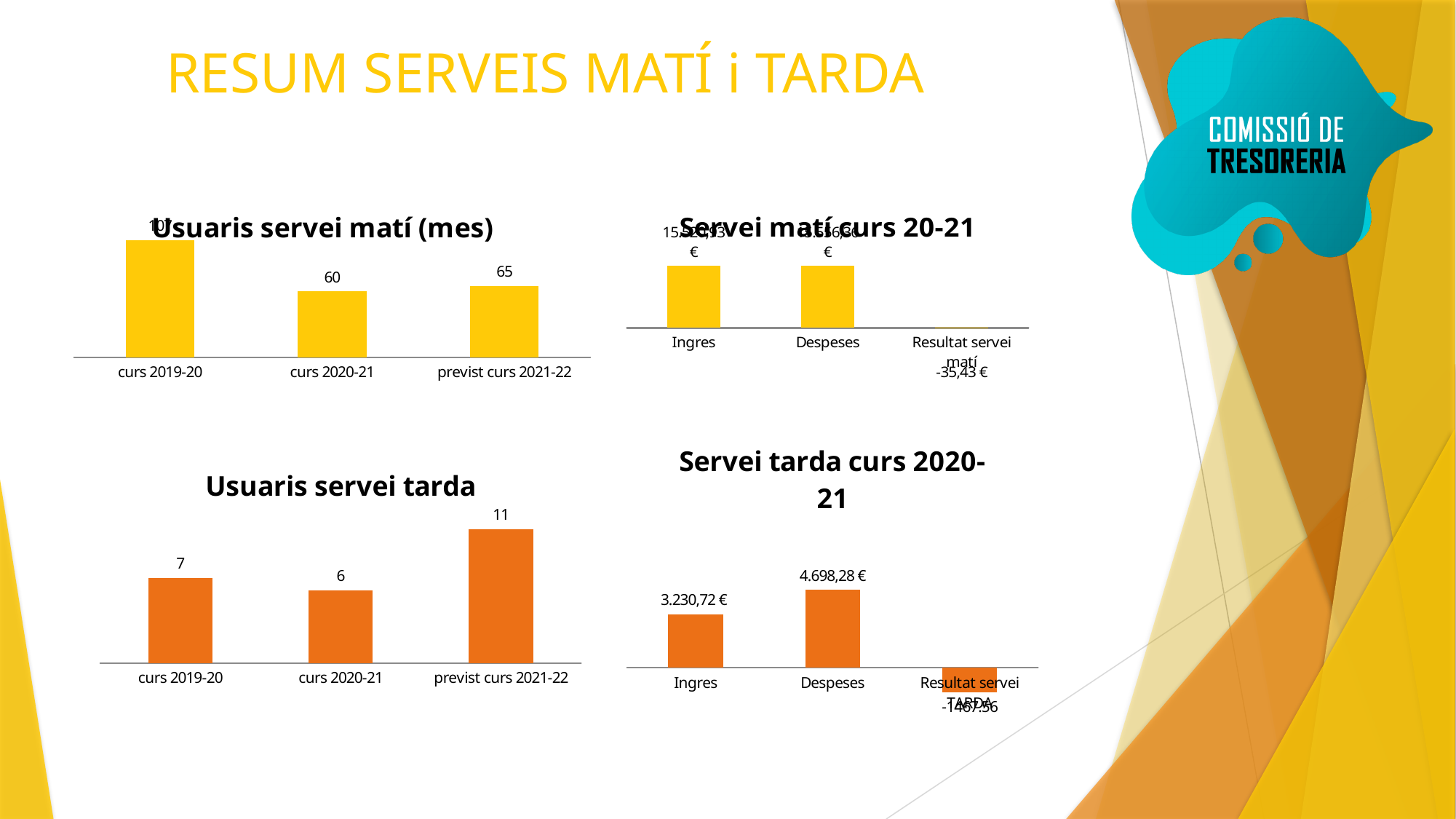
In the 'Usuaris servei matí (mes)' chart, which category has the lowest value? curs 2020-21 In the 'Servei tarda curs 2020-21' chart, what is the value for Despeses? 4.698,28 € In the 'Servei tarda curs 2020-21' chart, which is larger, Ingres or Despeses? Despeses In the 'Usuaris servei tarda' chart, which category has the lowest value? curs 2020-21 In the 'Usuaris servei tarda' chart, what is the difference between previst curs 2021-22 and curs 2019-20? 4 How many categories are shown in the 'Usuaris servei tarda' chart? 3 In the 'Usuaris servei tarda' chart, what is the value for previst curs 2021-22? 11 In the 'Usuaris servei matí (mes)' chart, what is the value for curs 2020-21? 60 In the 'Usuaris servei matí (mes)' chart, which category has the highest value? curs 2019-20 In the 'Usuaris servei matí (mes)' chart, what is the value for previst curs 2021-22? 65 In the 'Servei matí curs 20-21' chart, what is the value for Resultat servei matí? -35,43 € In the 'Servei tarda curs 2020-21' chart, what is the value for Ingres? 3.230,72 €